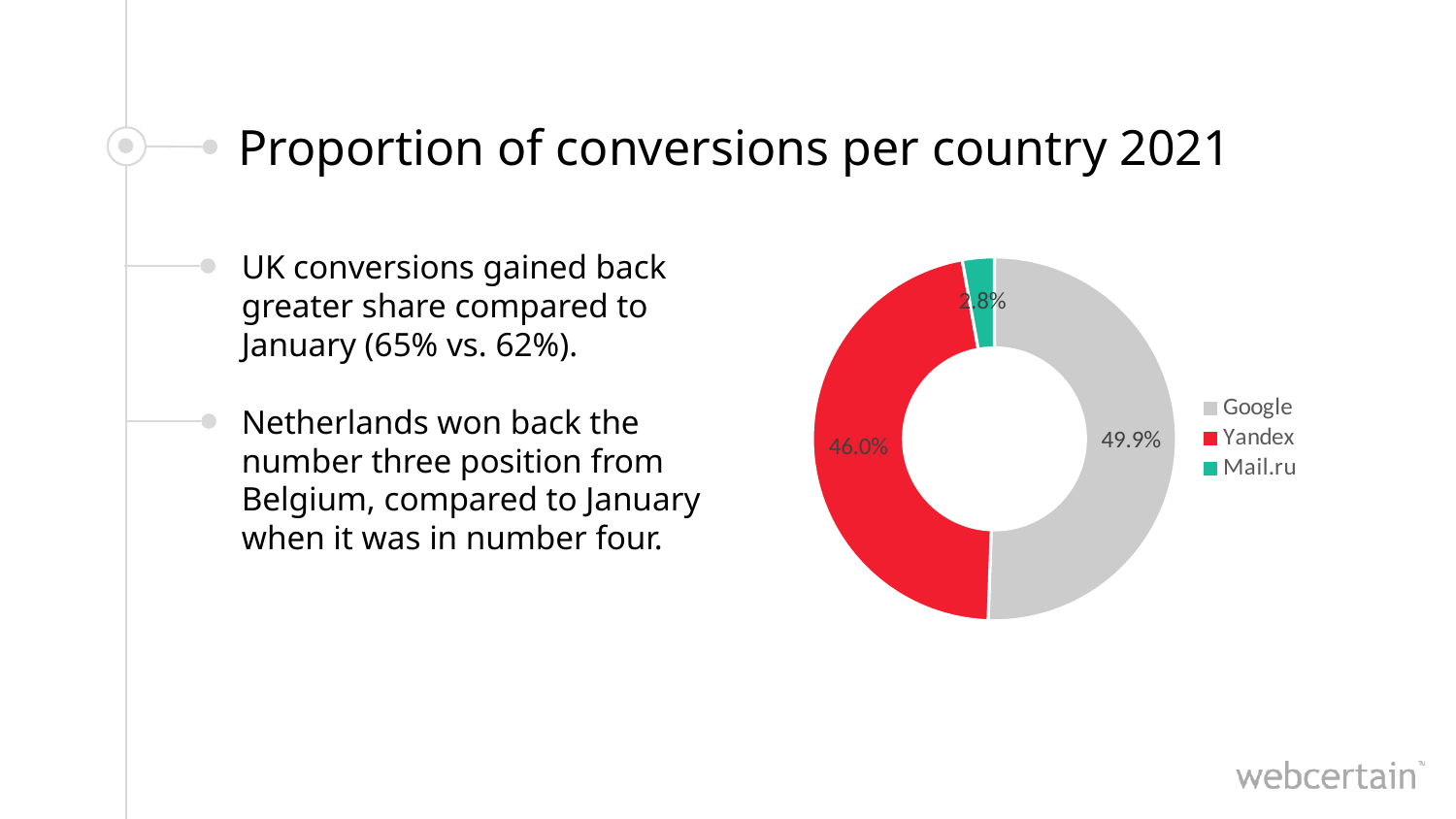
How many percentage points larger is Google's share than Yandex's share? 3.9 percentage points Which search engine has the largest share in the chart? Google Which has a larger share in the chart, Yandex or Mail.ru? Yandex What share of the doughnut chart does Google account for? 49.9% What colour represents Yandex in the chart? Red How many categories are shown in the chart? 3 Which entries are listed in the chart's legend? Google, Yandex, Mail.ru How many percentage points larger is Yandex's share than Mail.ru's share? 43.2 percentage points What kind of chart is shown on the slide? Doughnut chart What percentage is shown for Yandex in the chart? 46.0% Which search engine has the smallest share in the chart? Mail.ru What percentage is shown for Mail.ru in the chart? 2.8%